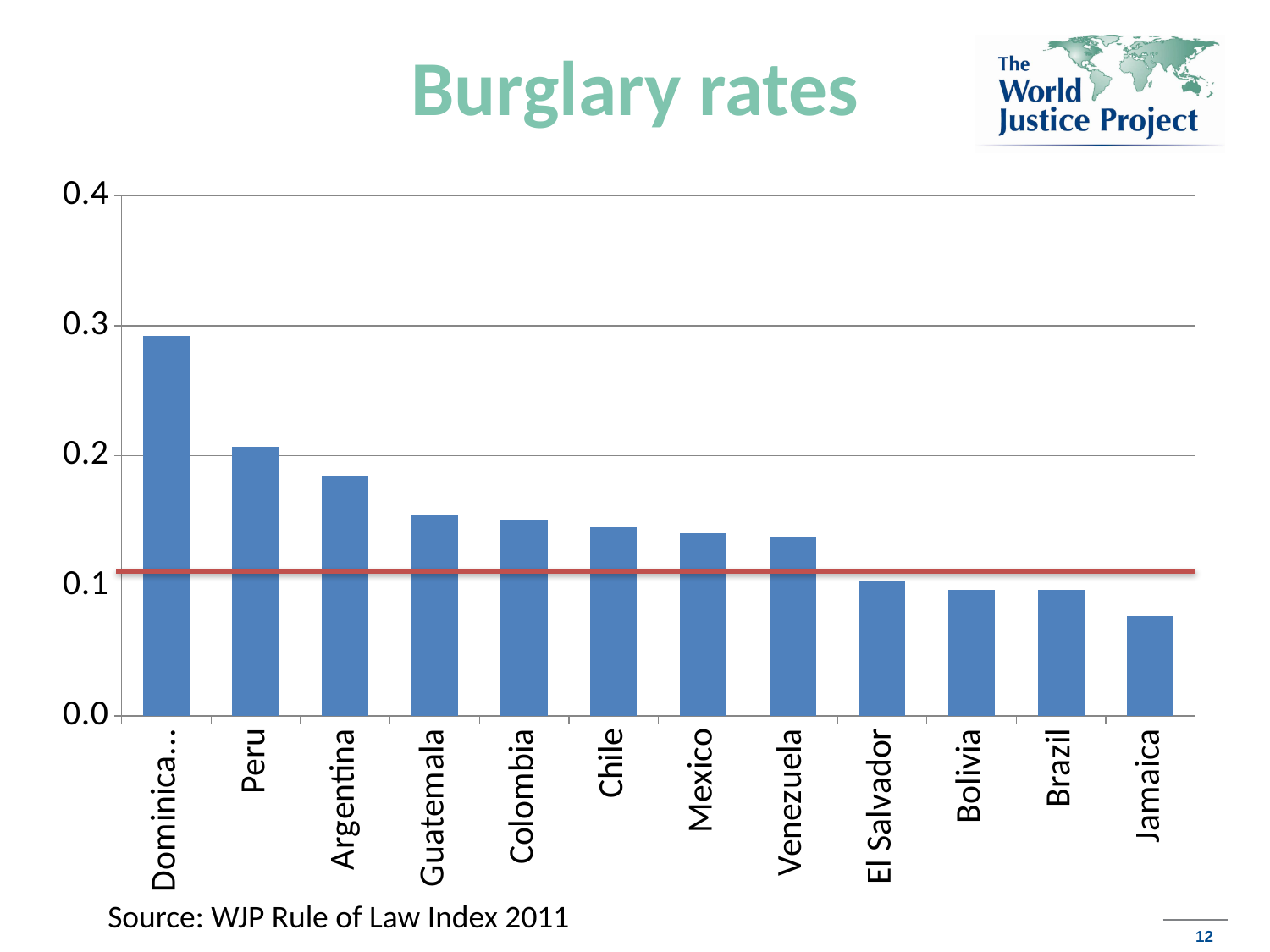
Is the value for Guatemala greater or less than 0.1? greater What kind of chart is shown on the slide? Bar chart Is the value for Peru greater or less than 0.3? less Is the value for Argentina greater or less than 0.2? less Which has a higher burglary rate, Peru or Argentina? Peru What is the title of the chart? Burglary rates Do the bar values rise or fall from left to right along the x axis? Fall Which has a higher burglary rate, Chile or Jamaica? Chile Which country has the lowest burglary rate in the chart? Jamaica What is the source cited below the chart? WJP Rule of Law Index 2011 How many countries are shown on the x axis of the chart? 12